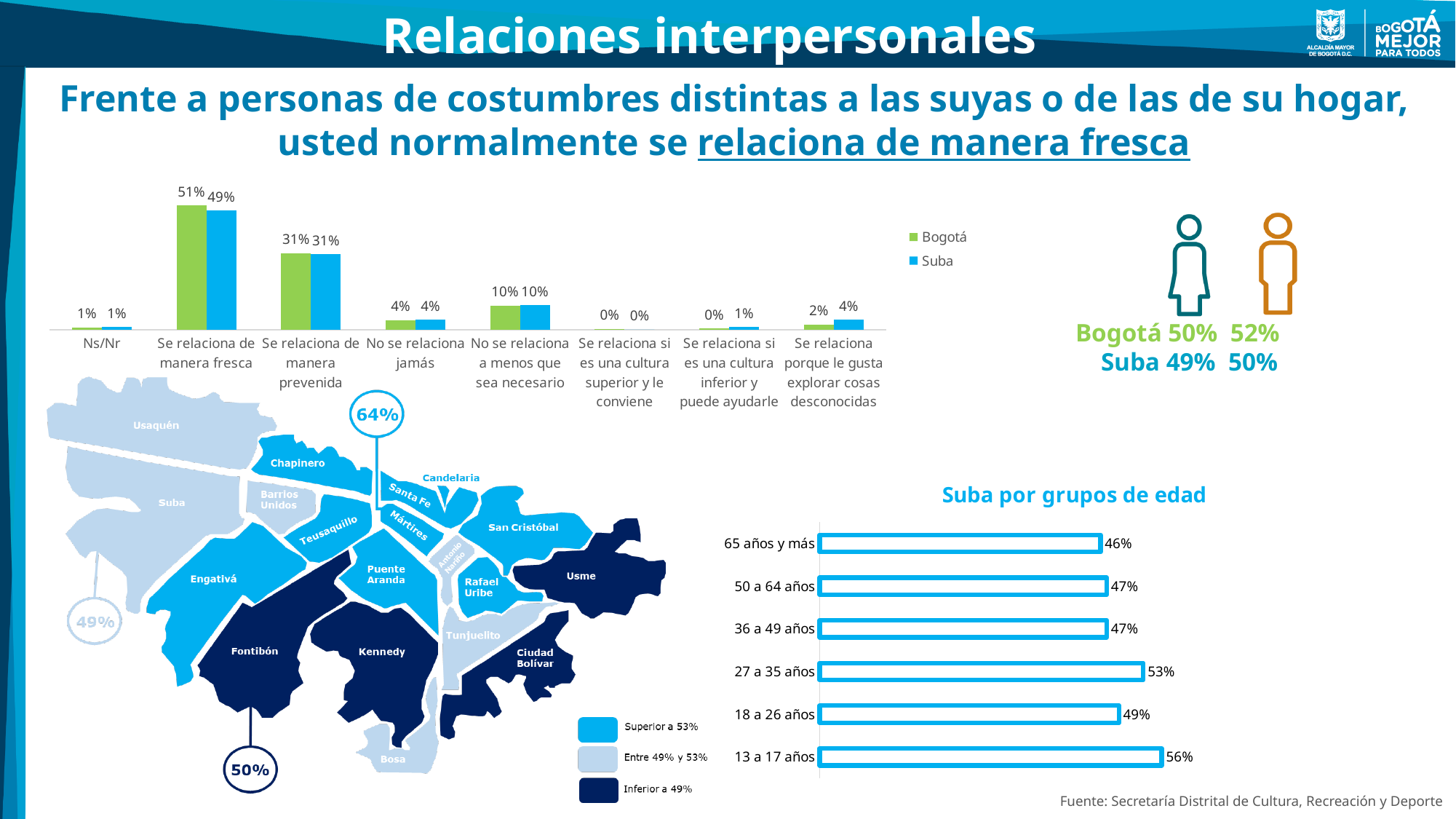
In the chart 'Suba por grupos de edad', which age group has the lowest value? 65 años y más In the top bar chart, how many series does the legend list? 2 In the top bar chart, which category has the highest value for Bogotá? Se relaciona de manera fresca In the chart 'Suba por grupos de edad', which age group has the highest value? 13 a 17 años In the chart 'Suba por grupos de edad', what is the difference between the values for '13 a 17 años' and '65 años y más'? 10% In the top bar chart, what is the value for Suba in the category 'Se relaciona de manera fresca'? 49% In the top bar chart, how many categories are shown on the x axis? 8 What kind of chart is 'Suba por grupos de edad'? Bar chart In the top bar chart, what is the difference between the Bogotá and Suba values for 'Se relaciona de manera fresca'? 2% In the top bar chart, what is the value for Suba in the category 'Se relaciona porque le gusta explorar cosas desconocidas'? 4% In the top bar chart, what is the value for Bogotá in the category 'Se relaciona de manera prevenida'? 31% In the chart 'Suba por grupos de edad', what is the value for '27 a 35 años'? 53%